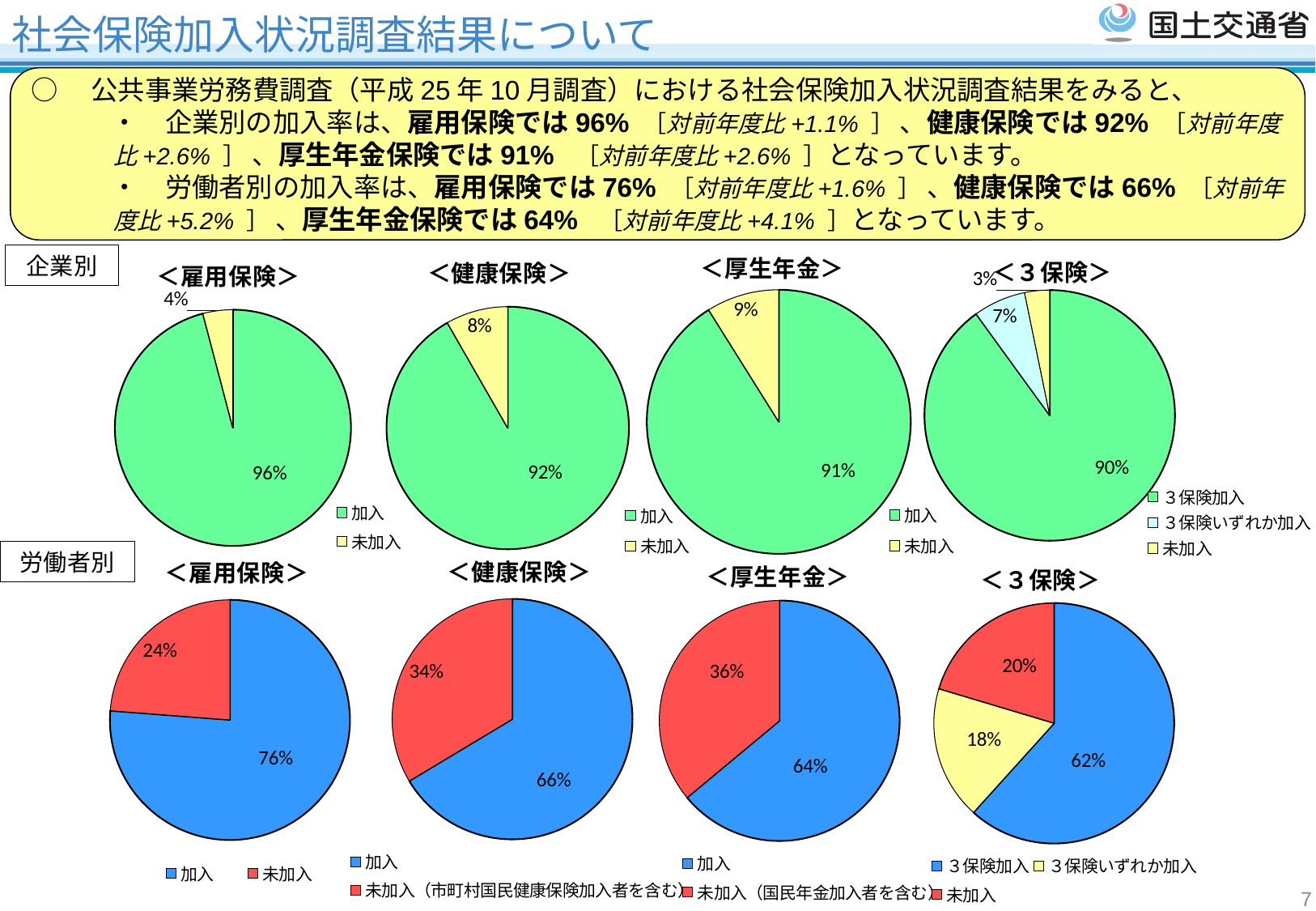
What type of chart is used for the 企業別 <雇用保険> chart? Pie chart In the 労働者別 <健康保険> pie chart, what is the difference between the 加入 and 未加入 slices? 32% In the 企業別 <３保険> pie chart, what percentage is labelled for ３保険いずれか加入? 7% In the 労働者別 <雇用保険> pie chart, what percentage is labelled for 未加入? 24% In the 企業別 <雇用保険> pie chart, what percentage is labelled for 加入? 96% In the 企業別 <厚生年金> pie chart, what share of the pie is 加入? 91% In the 労働者別 <３保険> pie chart, which slice is the smallest? ３保険いずれか加入 In the 労働者別 <厚生年金> pie chart, which slice is larger, 加入 or 未加入? 加入 In the 企業別 <健康保険> pie chart, what percentage is labelled for 未加入? 8% In the 労働者別 <３保険> pie chart, what percentage is labelled for ３保険加入? 62% How many slices does the 企業別 <３保険> pie chart have? 3 How many entries does the legend of the 労働者別 <３保険> pie chart list? 3